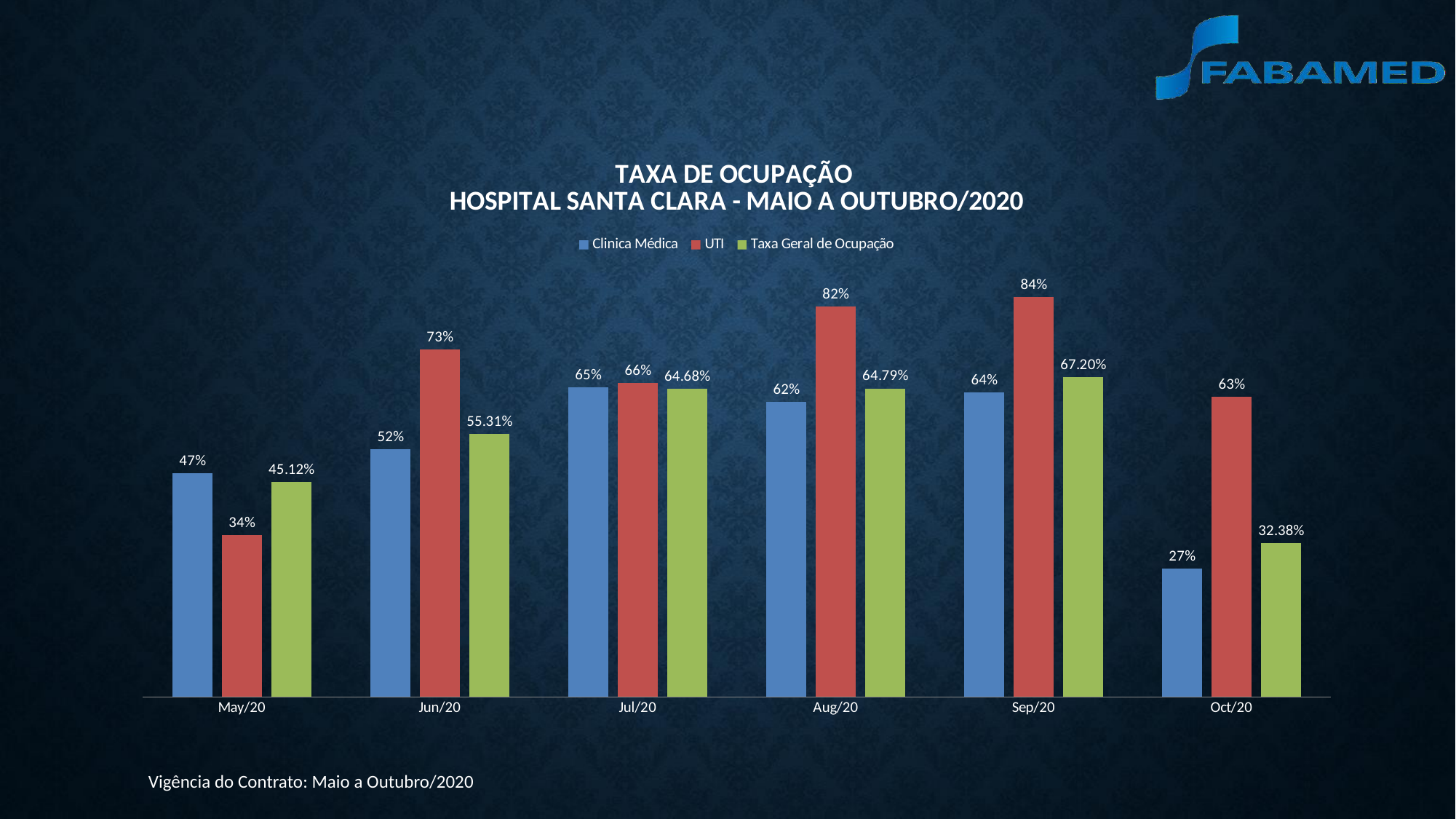
What is the Clinica Médica value for Oct/20? 27% How many months are shown on the x axis? 6 In which month is the UTI value highest? Sep/20 How many series does the legend list? 3 What is the UTI occupancy rate for Sep/20? 84% What is the difference between the UTI and Clinica Médica values in Aug/20? 20% In which month is the Clinica Médica value lowest? Oct/20 What kind of chart is shown on the slide? Bar chart What is the Taxa Geral de Ocupação value for Jun/20? 55.31% Which is larger in May/20, Clinica Médica or UTI? Clinica Médica Which colour represents the UTI series in the legend? Red Does the UTI value rise or fall from Sep/20 to Oct/20? Fall